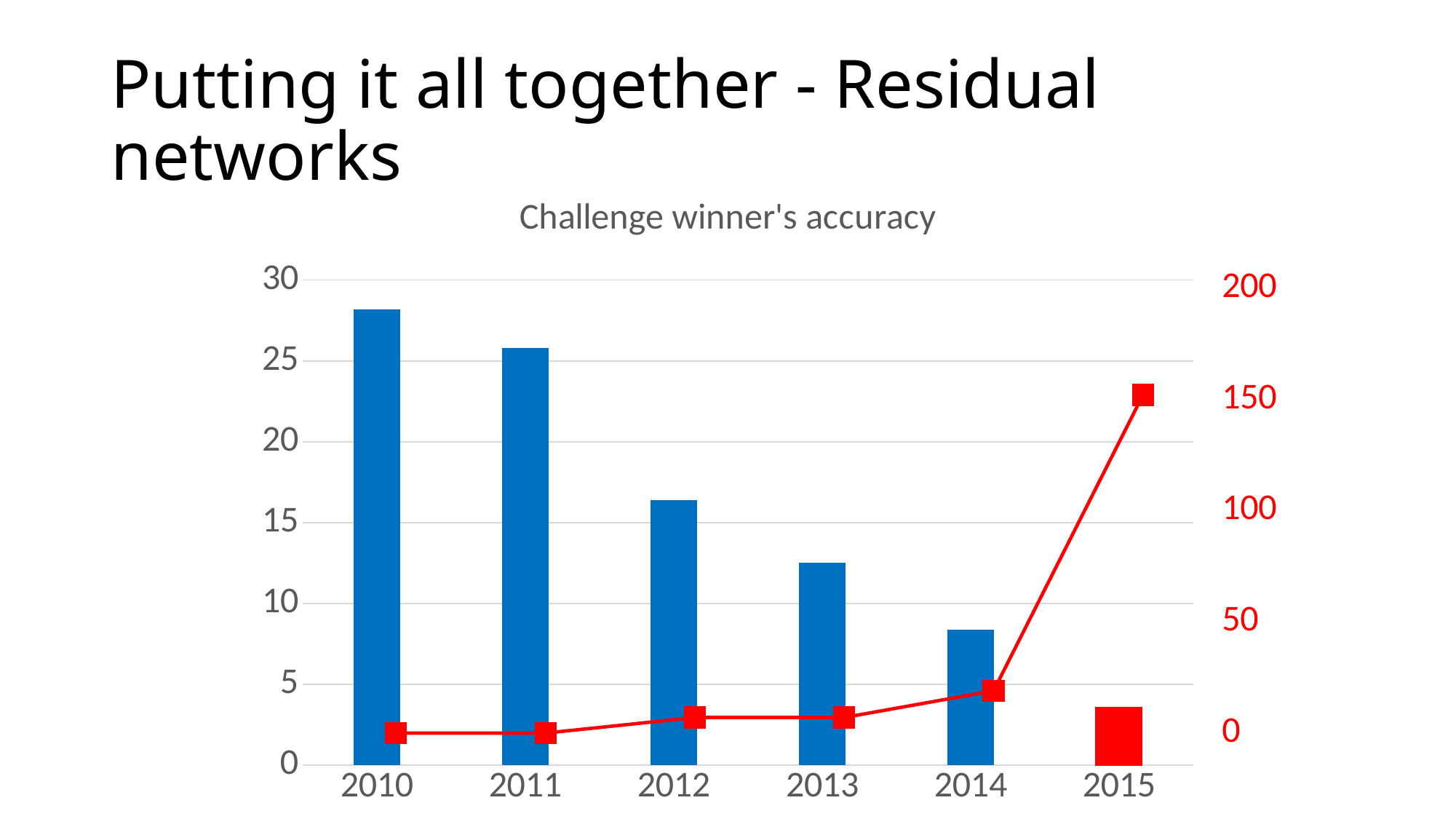
Which year has the taller bar, 2011 or 2012? 2011 Is the line value for 2015 greater or less than 100 on the right axis? greater Is the bar value for 2015 greater or less than 5 on the left axis? less Is the bar value for 2013 greater or less than 10 on the left axis? greater What is the title of the chart? Challenge winner's accuracy How many years are shown on the x axis of the chart? 6 Which year has the tallest bar in the chart? 2010 Which year has the shortest bar in the chart? 2015 Do the bar values rise or fall from 2010 to 2015? fall What kind of chart is shown on the slide? A combined bar and line chart